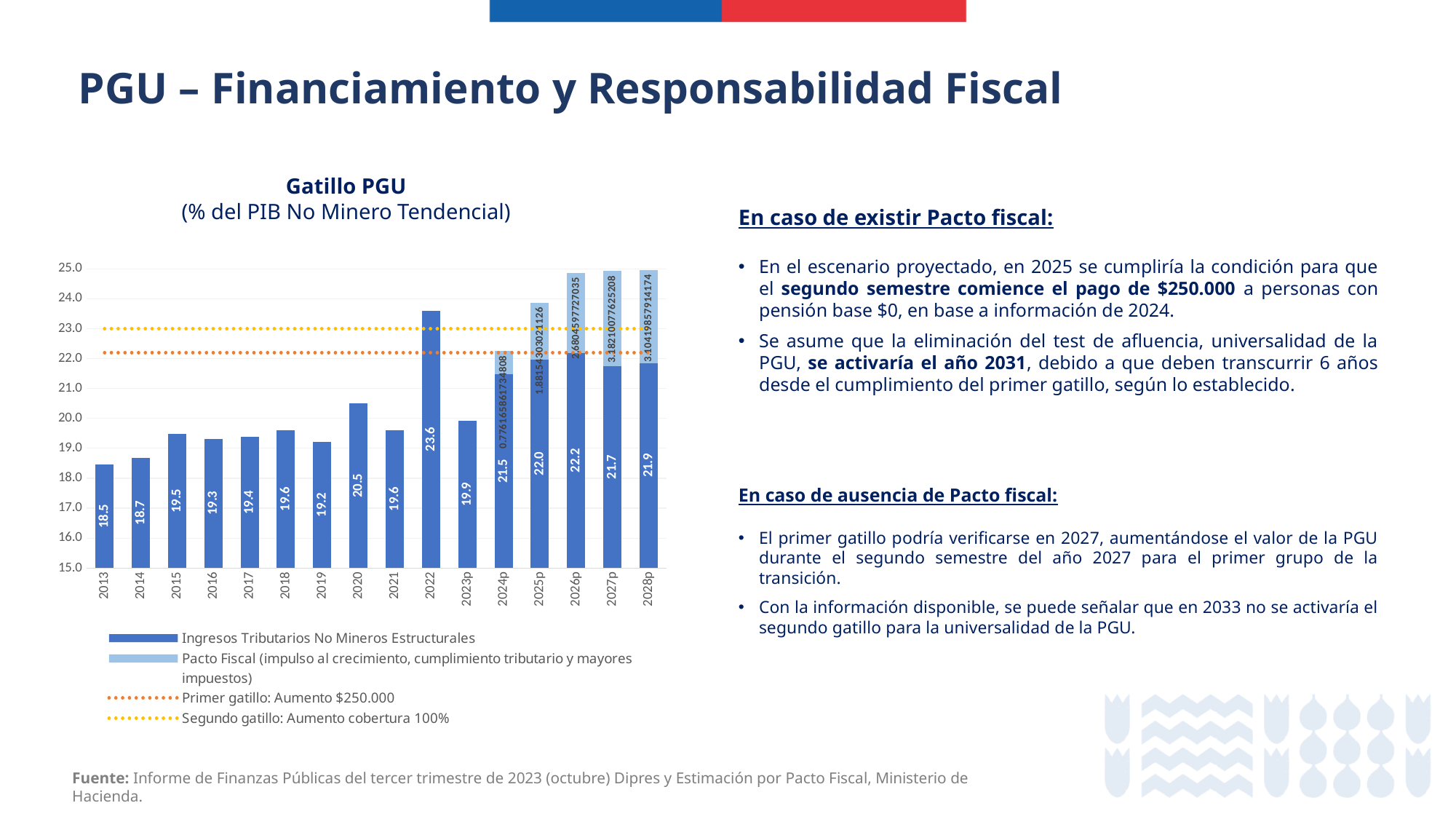
How many years are shown on the x axis of the chart? 16 Is the Ingresos Tributarios No Mineros Estructurales value for 2023p greater or less than 20.0? less What is the value of Ingresos Tributarios No Mineros Estructurales for 2020? 20.5 What is the value of Ingresos Tributarios No Mineros Estructurales for 2025p? 22.0 Which year has the lowest value for Ingresos Tributarios No Mineros Estructurales? 2013 Which year has the highest value for Ingresos Tributarios No Mineros Estructurales? 2022 What is the difference between the Ingresos Tributarios No Mineros Estructurales values for 2022 and 2013? 5.1 What is the title of the chart? Gatillo PGU (% del PIB No Minero Tendencial) How many entries does the chart legend list? 4 What is the value of Ingresos Tributarios No Mineros Estructurales for 2022? 23.6 Which is larger, the Ingresos Tributarios No Mineros Estructurales value for 2020 or for 2021? 2020 What kind of chart is shown on the slide? Bar chart